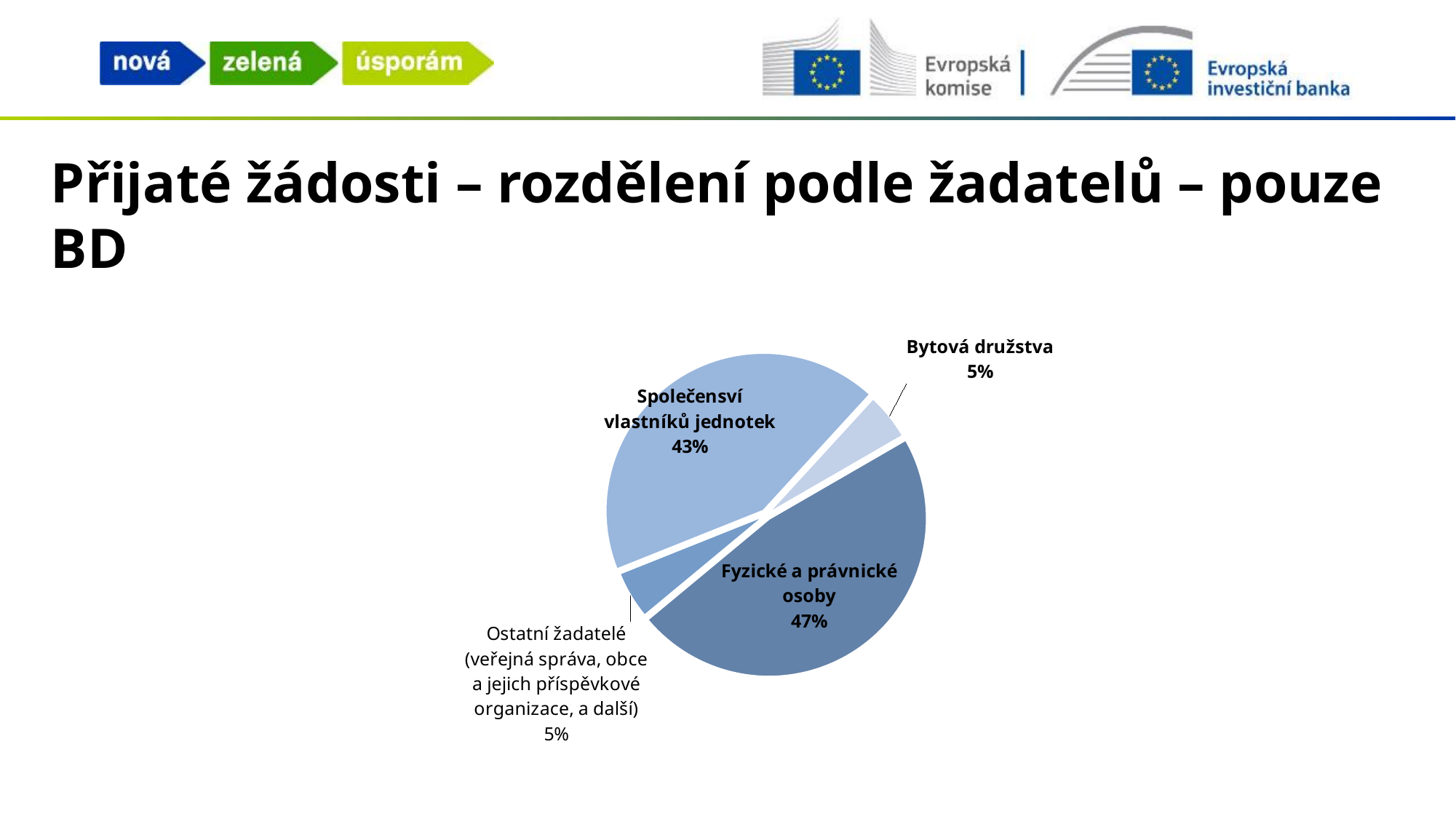
Which slice of the pie is drawn in the darkest blue? Fyzické a právnické osoby What kind of chart is shown on the slide? pie chart What is the difference in percentage points between "Fyzické a právnické osoby" and "Společensví vlastníků jednotek"? 4 Which category has the largest slice of the pie? Fyzické a právnické osoby How many slices does the pie chart have? 4 What is the difference in percentage points between "Společensví vlastníků jednotek" and "Bytová družstva"? 38 What share of the pie does "Ostatní žadatelé" have? 5% What share of the pie does "Společensví vlastníků jednotek" have? 43% What is the title of the slide containing the chart? Přijaté žádosti – rozdělení podle žadatelů – pouze BD What share of the pie does "Fyzické a právnické osoby" have? 47% Which is larger, the share for "Společensví vlastníků jednotek" or the share for "Bytová družstva"? Společensví vlastníků jednotek